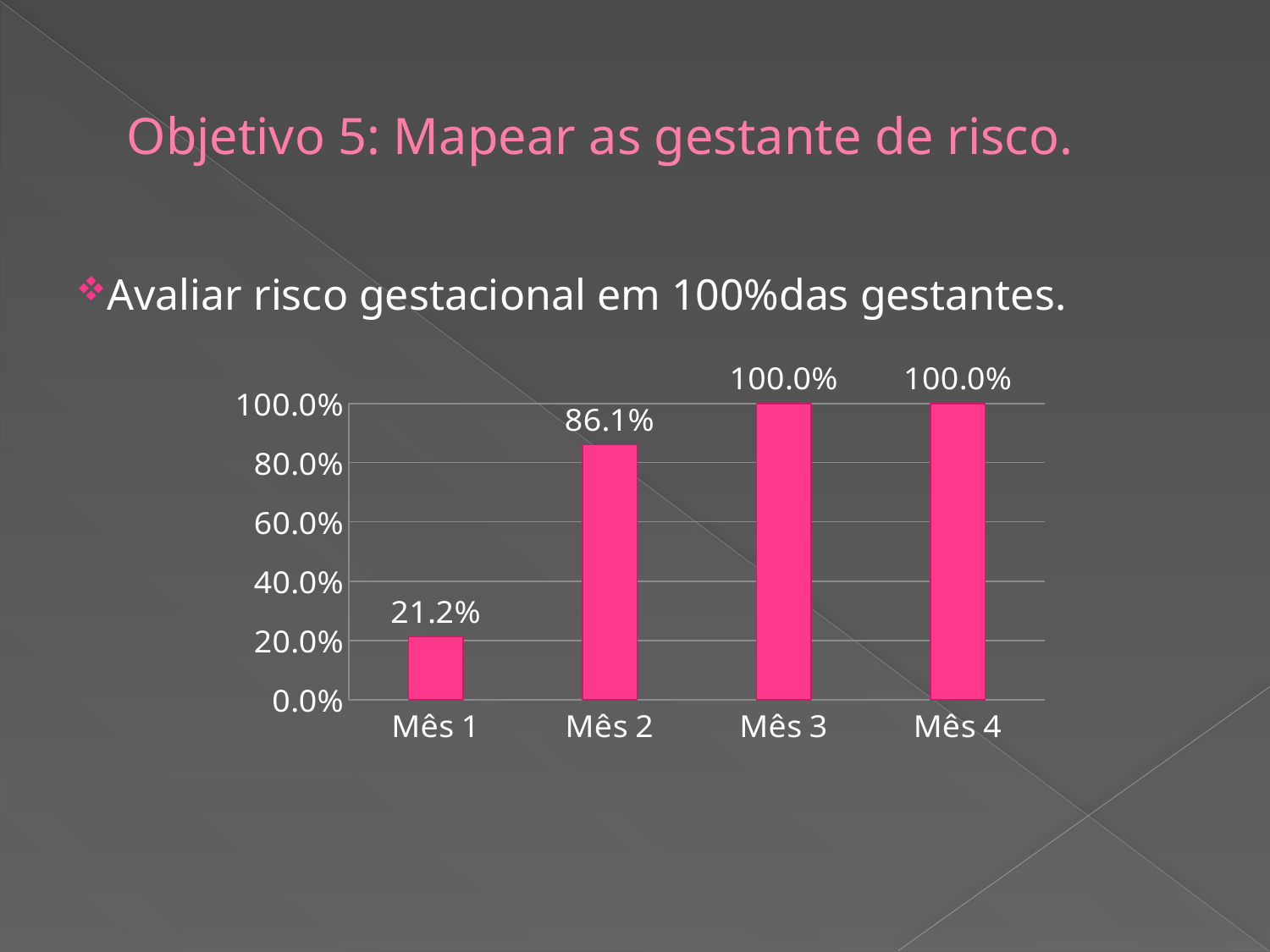
What is the value for Mês 2? 86.1% Which is larger, the value for Mês 1 or the value for Mês 2? Mês 2 What is the difference between the values for Mês 3 and Mês 2? 13.9% What kind of chart is shown on the slide? bar chart Which category has the lowest value? Mês 1 How many categories are shown on the x axis? 4 What is the difference between the values for Mês 2 and Mês 1? 64.9% What is the value for Mês 3? 100.0% What is the value for Mês 1? 21.2% Is the value for Mês 2 greater or less than 80.0%? greater What colour are the bars in the chart? pink Do the values rise or fall from Mês 1 to Mês 3? rise